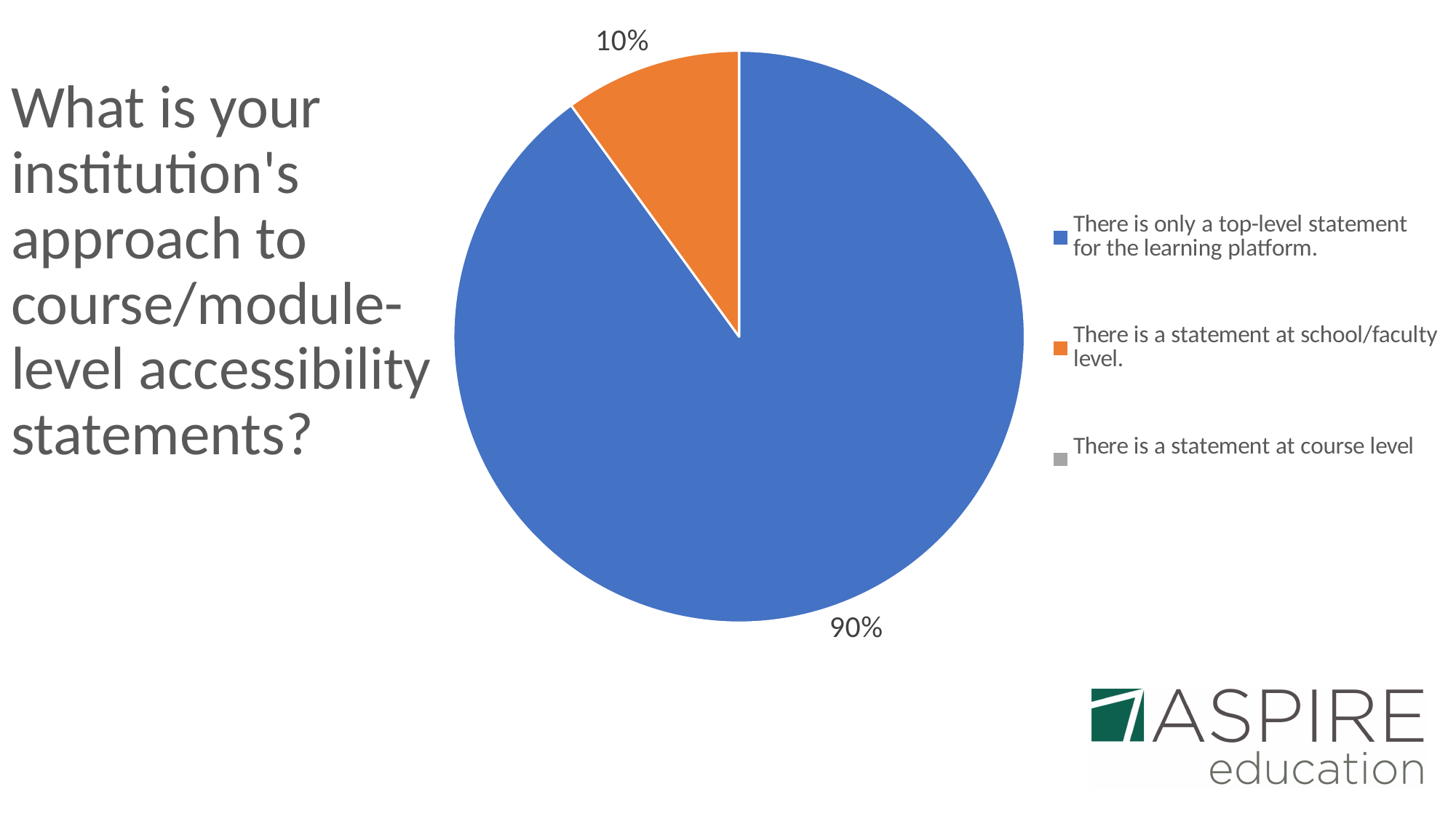
How many entries does the legend list? 3 Which is larger: the slice for 'There is only a top-level statement for the learning platform.' or the slice for 'There is a statement at school/faculty level.'? There is only a top-level statement for the learning platform. How many slices with a percentage label are visible in the pie? 2 What share of the pie is labelled for 'There is a statement at school/faculty level.'? 10% Which legend entry has no visible slice in the pie? There is a statement at course level What share of the pie is labelled for 'There is only a top-level statement for the learning platform.'? 90% Which of the two labelled slices is smaller? There is a statement at school/faculty level. Which category has the largest slice of the pie? There is only a top-level statement for the learning platform. What kind of chart is shown on the slide? Pie chart What is the difference in percentage points between the 'top-level statement' slice and the 'school/faculty level' slice? 80 What colour is the slice for 'There is a statement at school/faculty level.'? Orange